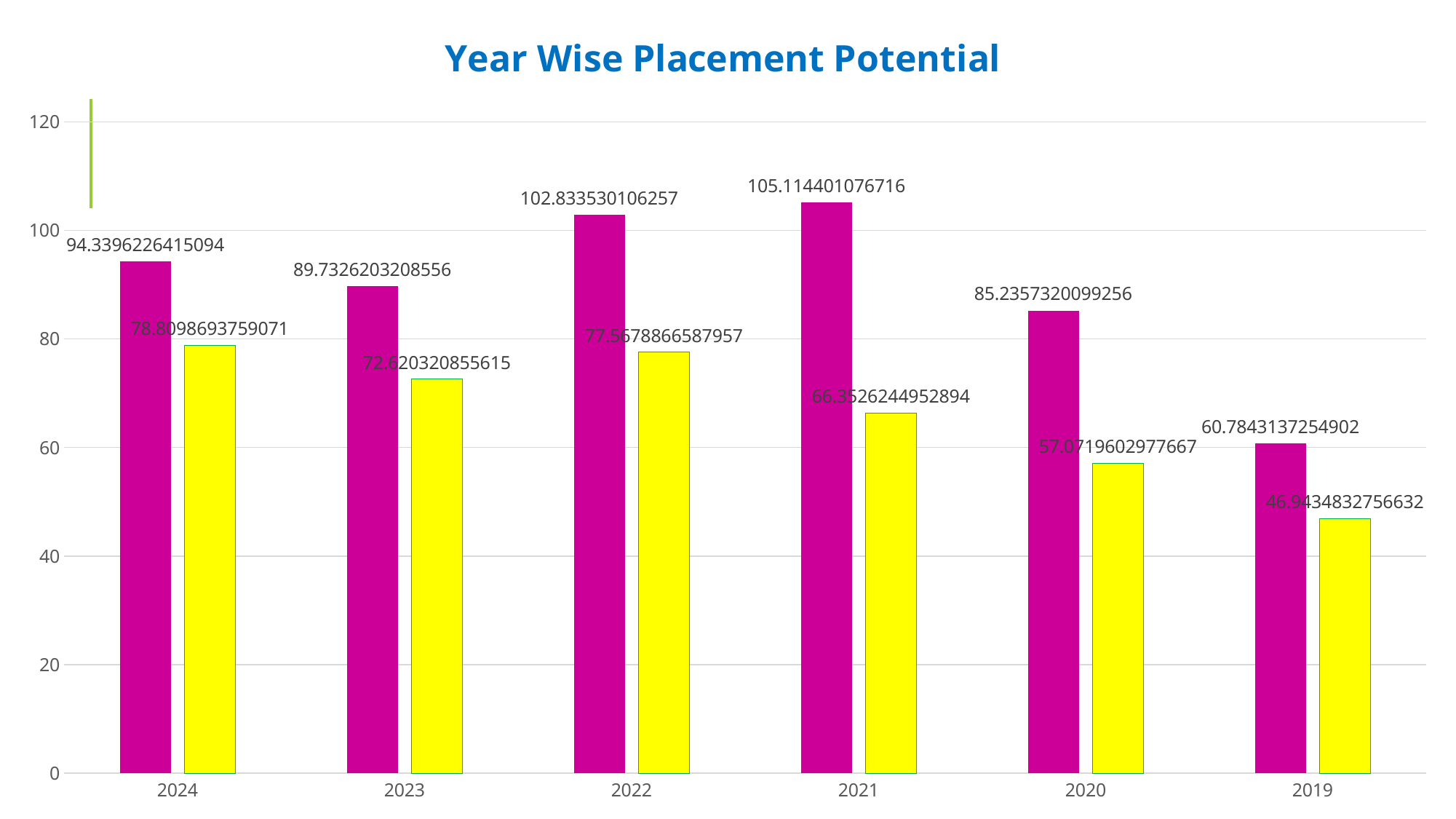
Is the value of the yellow bar for 2020 greater or less than 60? less Which year has the lowest yellow bar? 2019 Which is larger, the magenta bar for 2022 or the magenta bar for 2024? 2022 How many years are shown on the x axis of the chart? 6 What is the value of the yellow bar for 2019? 46.9434832756632 What is the value of the yellow bar for 2023? 72.620320855615 What kind of chart is shown on the slide? bar chart Do the magenta bar values rise or fall from 2021 to 2019 along the x axis? fall Which year has the highest magenta bar? 2021 What is the value of the magenta bar for 2020? 85.2357320099256 What is the value of the magenta bar for 2021? 105.114401076716 What is the title of the chart? Year Wise Placement Potential